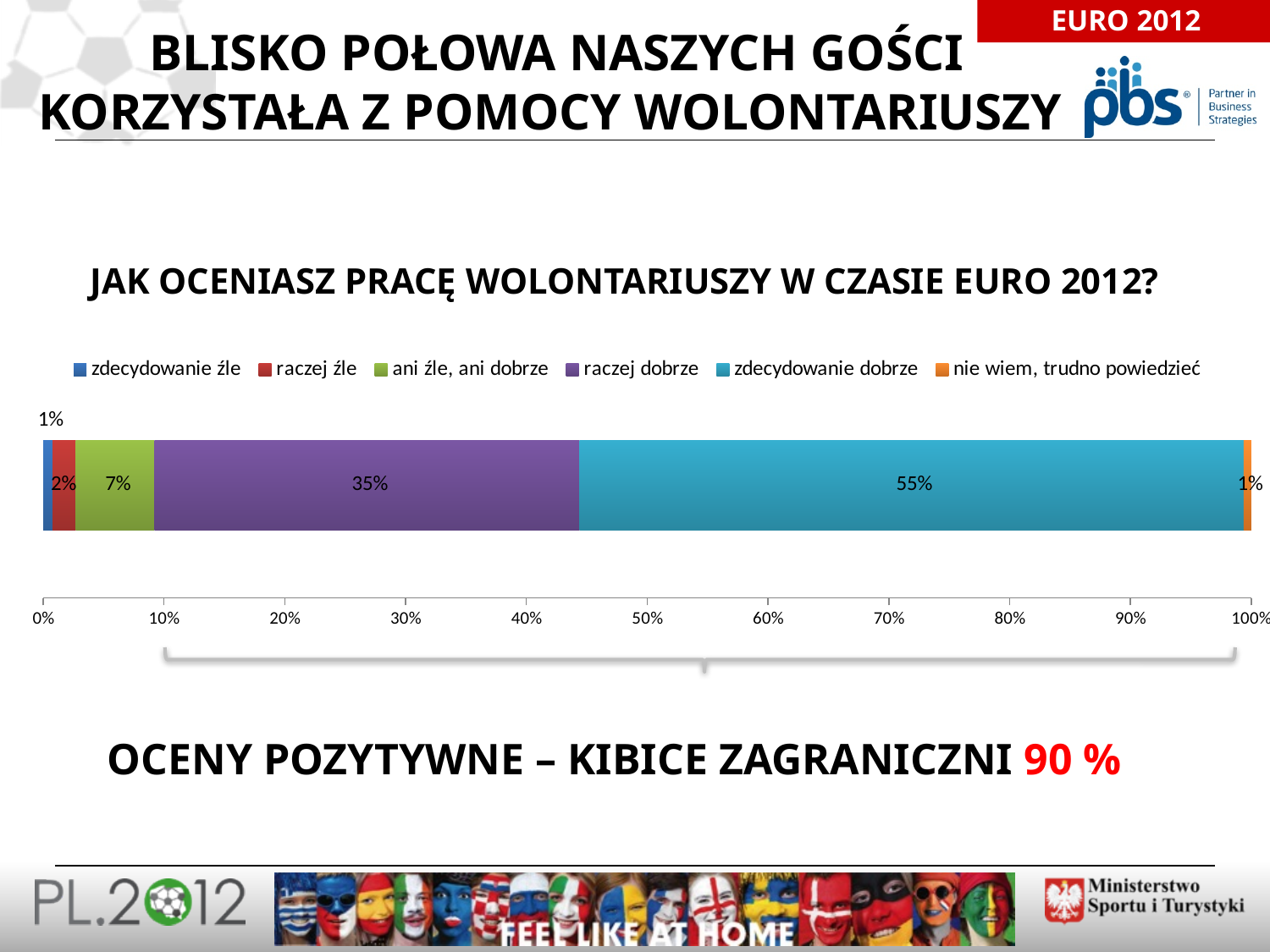
How many series does the legend list? 6 What question does the chart title ask? JAK OCENIASZ PRACĘ WOLONTARIUSZY W CZASIE EURO 2012? What is the value for "nie wiem, trudno powiedzieć"? 1% What is the difference between the values for "zdecydowanie dobrze" and "raczej dobrze"? 20% What is the combined value of "raczej dobrze" and "zdecydowanie dobrze"? 90% What is the value for "ani źle, ani dobrze"? 7% Which is larger, the value for "ani źle, ani dobrze" or the value for "raczej źle"? ani źle, ani dobrze What is the value for "zdecydowanie dobrze"? 55% Which response category has the highest value? zdecydowanie dobrze What is the value for "raczej dobrze"? 35% What is the value for "raczej źle"? 2% What kind of chart is shown on the slide? stacked bar chart